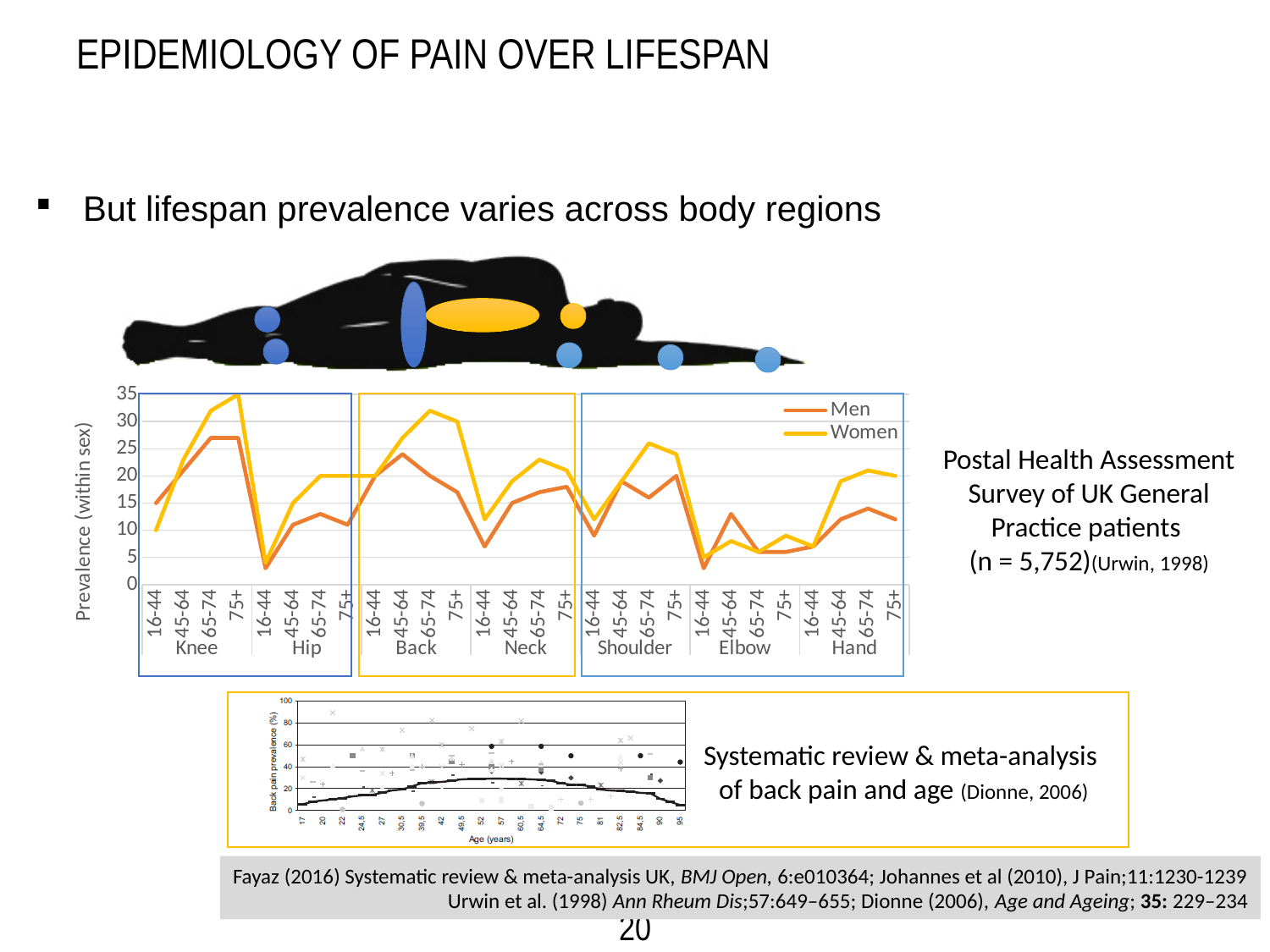
What are the two series named in the legend of the prevalence chart? Men and Women In the prevalence chart, is the Men value for Hip at age 16-44 greater or less than 5? less In the prevalence chart, does the Women value for Knee rise or fall from age 16-44 to 75+? rise In the prevalence chart, is the Women value for Back at age 65-74 greater or less than 25? greater In the prevalence chart, which series is higher for Knee at age 75+, Men or Women? Women In the prevalence chart, which age group has the highest Women value for Knee? 75+ What kind of chart is the large chart showing prevalence by body region? line chart How many body regions are shown along the x axis of the prevalence chart? 7 How many age groups are plotted for each body region in the prevalence chart? 4 In the prevalence chart, which series is higher for Elbow at age 45-64, Men or Women? Men In the prevalence chart, is the Women value for Knee at age 75+ greater or less than 30? greater How many series does the legend of the prevalence chart list? 2